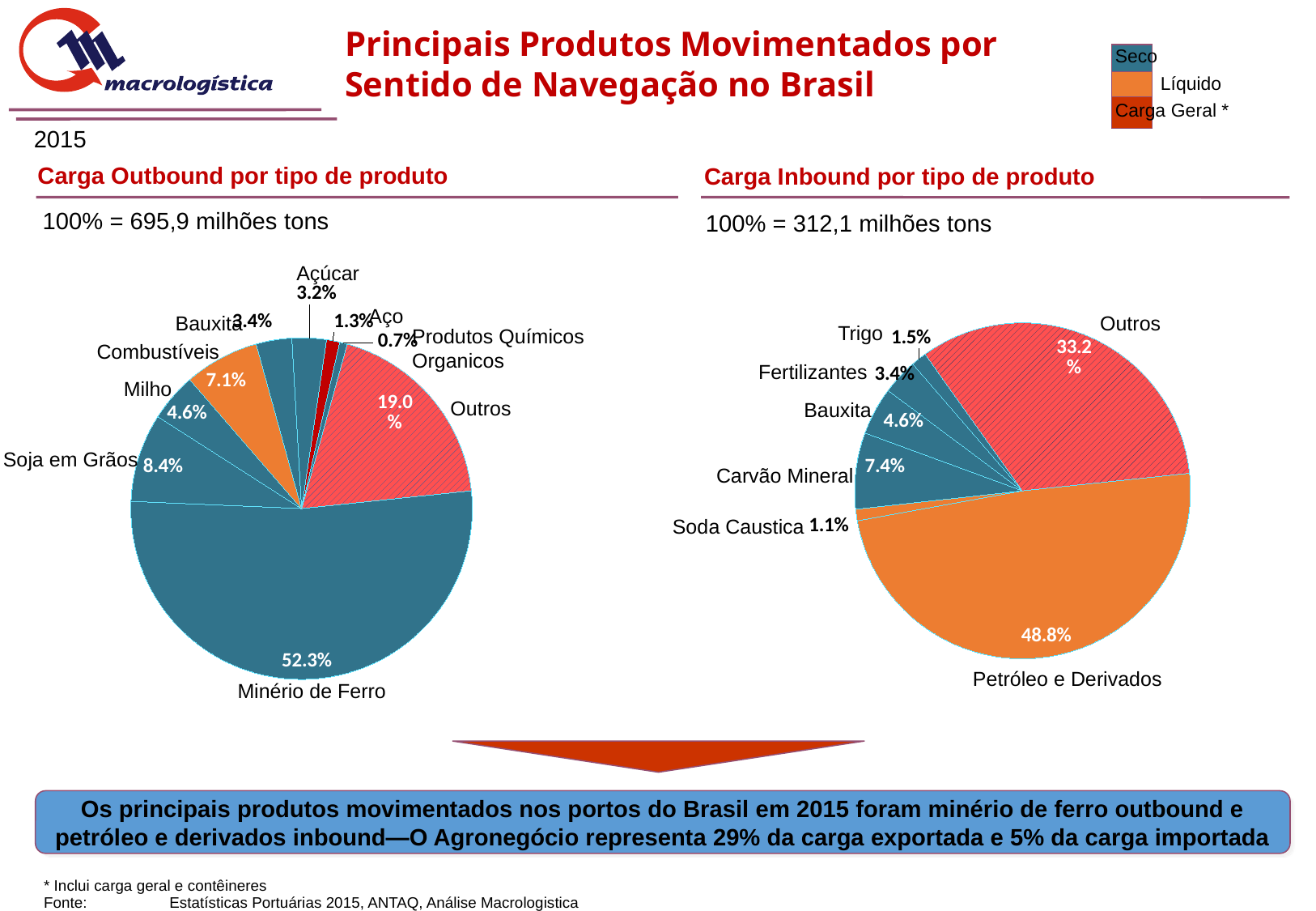
In the 'Carga Inbound por tipo de produto' chart, what is the value for Carvão Mineral? 7.4% What type of chart is used for 'Carga Outbound por tipo de produto'? Pie chart In the 'Carga Outbound por tipo de produto' chart, what is the difference between the Combustíveis and Milho shares? 2.5% In the 'Carga Outbound por tipo de produto' chart, what share does Minério de Ferro have? 52.3% In the 'Carga Inbound por tipo de produto' chart, which is larger: Bauxita or Fertilizantes? Bauxita In the 'Carga Inbound por tipo de produto' chart, which product has the smallest slice? Soda Caustica How many slices does the 'Carga Inbound por tipo de produto' pie chart have? 7 How many slices does the 'Carga Outbound por tipo de produto' pie chart have? 9 In the 'Carga Outbound por tipo de produto' chart, which product has the largest slice? Minério de Ferro In the 'Carga Outbound por tipo de produto' chart, what is the value for Soja em Grãos? 8.4% In the 'Carga Inbound por tipo de produto' chart, what share does Petróleo e Derivados have? 48.8% What total tonnage does 100% represent in the 'Carga Inbound por tipo de produto' chart? 312,1 milhões tons